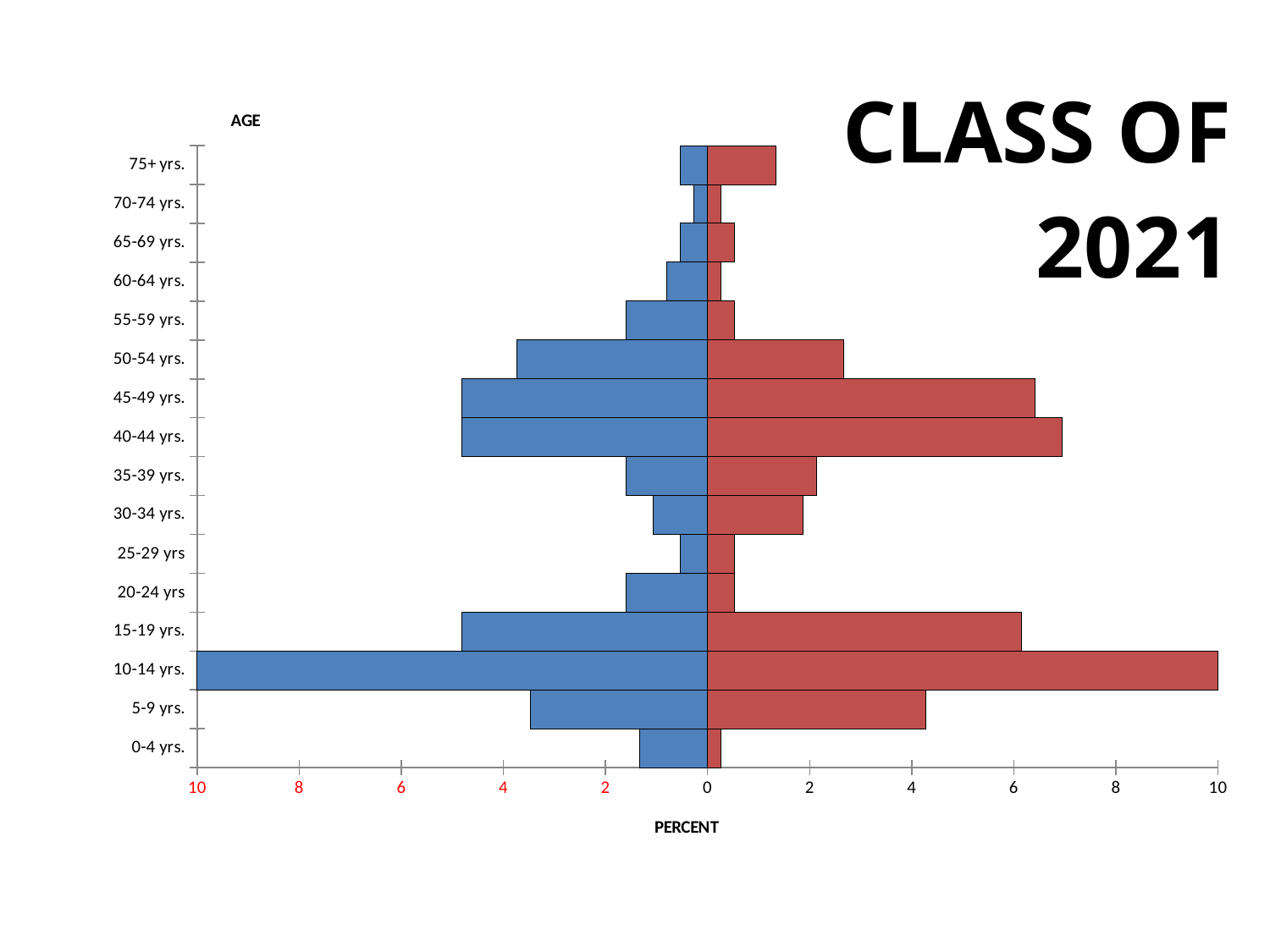
Which age category has the shortest blue bar? 70-74 yrs. Which age category has the longest red bar? 10-14 yrs. What is the label of the horizontal axis? PERCENT Which age category has the longest blue bar? 10-14 yrs. Is the value of the blue bar for 5-9 yrs. greater or less than 4? less Is the value of the red bar for 40-44 yrs. greater or less than 6? greater What kind of chart is shown on the slide? bar chart How many age categories are shown on the chart? 16 For 40-44 yrs., which bar is longer, the blue bar or the red bar? red bar Is the value of the blue bar for 0-4 yrs. greater or less than 2? less For 0-4 yrs., which bar is longer, the blue bar or the red bar? blue bar